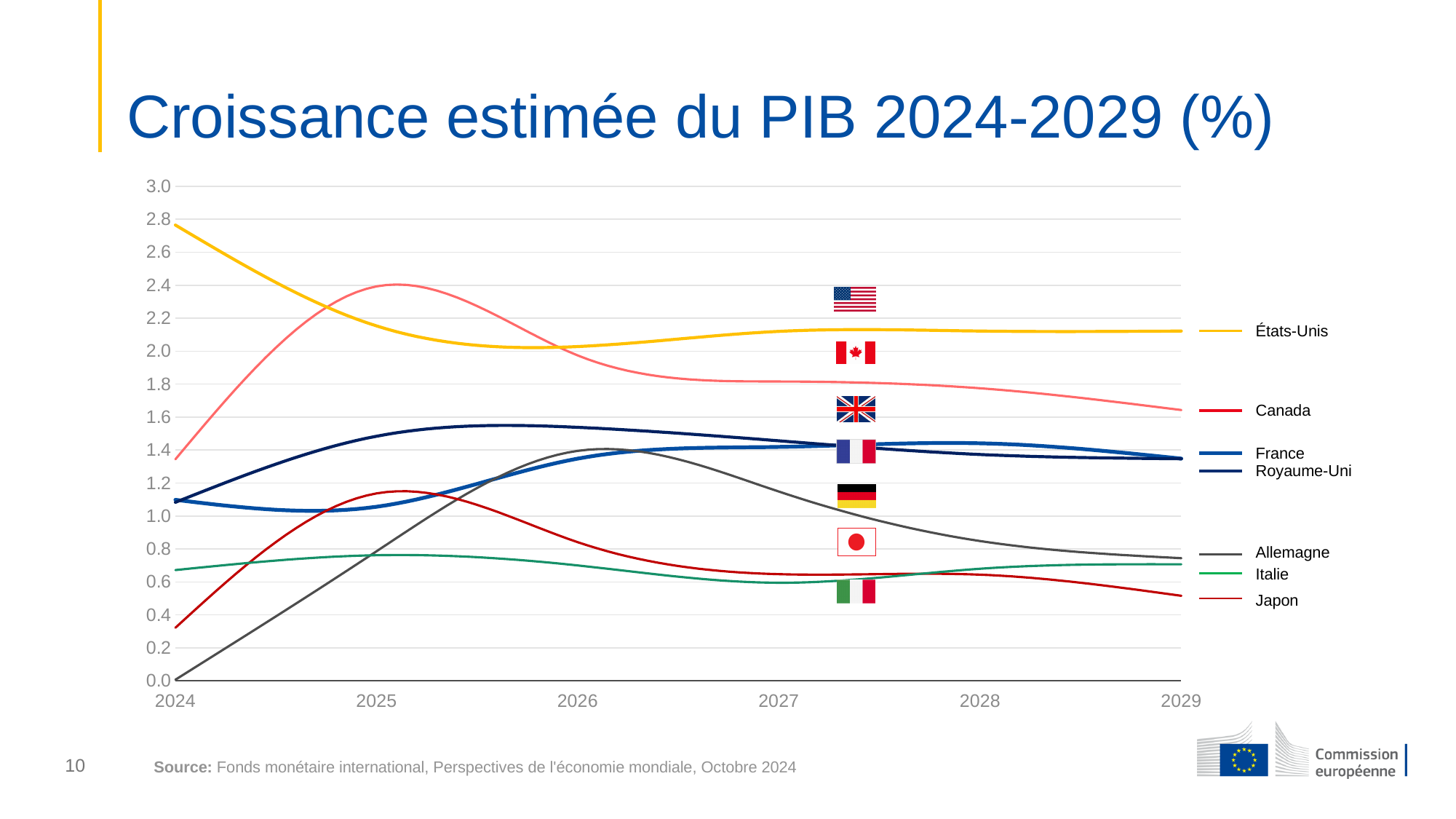
What is the title of the chart? Croissance estimée du PIB 2024-2029 (%) Is the value for Italie in 2024 greater or less than 0.8? less Is the value for Canada in 2025 greater or less than 2.2? greater How many series does the legend list? 7 Which country has the lowest estimated GDP growth in 2029? Japon Which country has the lowest estimated GDP growth in 2024? Allemagne Is the value for États-Unis in 2024 greater or less than 2.6? greater Which is larger in 2025, the value for Canada or the value for France? Canada Which country has the highest estimated GDP growth in 2024? États-Unis How many years are shown along the x axis? 6 Does the line for États-Unis rise or fall between 2024 and 2026? Fall What kind of chart is shown on the slide? Line chart